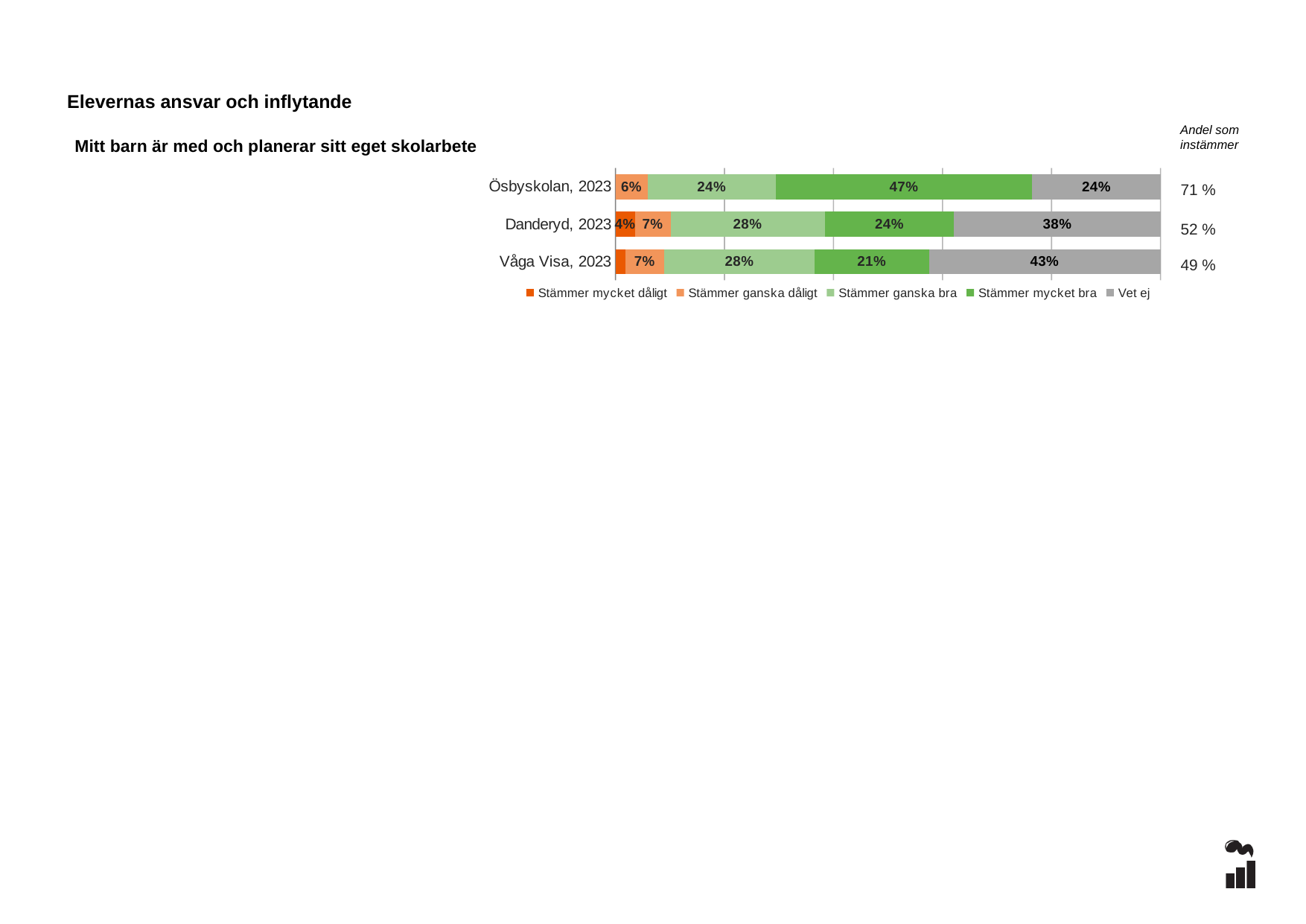
What is the 'Andel som instämmer' value shown for Ösbyskolan, 2023? 71 % What is the value of 'Stämmer ganska bra' for Danderyd, 2023? 28% How many series does the legend list? 5 Which is larger: the 'Vet ej' value for Danderyd, 2023 or for Våga Visa, 2023? Våga Visa, 2023 What kind of chart is shown on the slide? stacked bar chart What is the value of 'Stämmer mycket dåligt' for Danderyd, 2023? 4% Which category has the highest 'Stämmer mycket bra' value? Ösbyskolan, 2023 What is the value of 'Vet ej' for Våga Visa, 2023? 43% What is the difference between the 'Stämmer mycket bra' values for Ösbyskolan, 2023 and Danderyd, 2023? 23% How many categories (bars) are shown in the chart? 3 Which category has the lowest 'Vet ej' value? Ösbyskolan, 2023 What is the value of 'Stämmer mycket bra' for Ösbyskolan, 2023? 47%